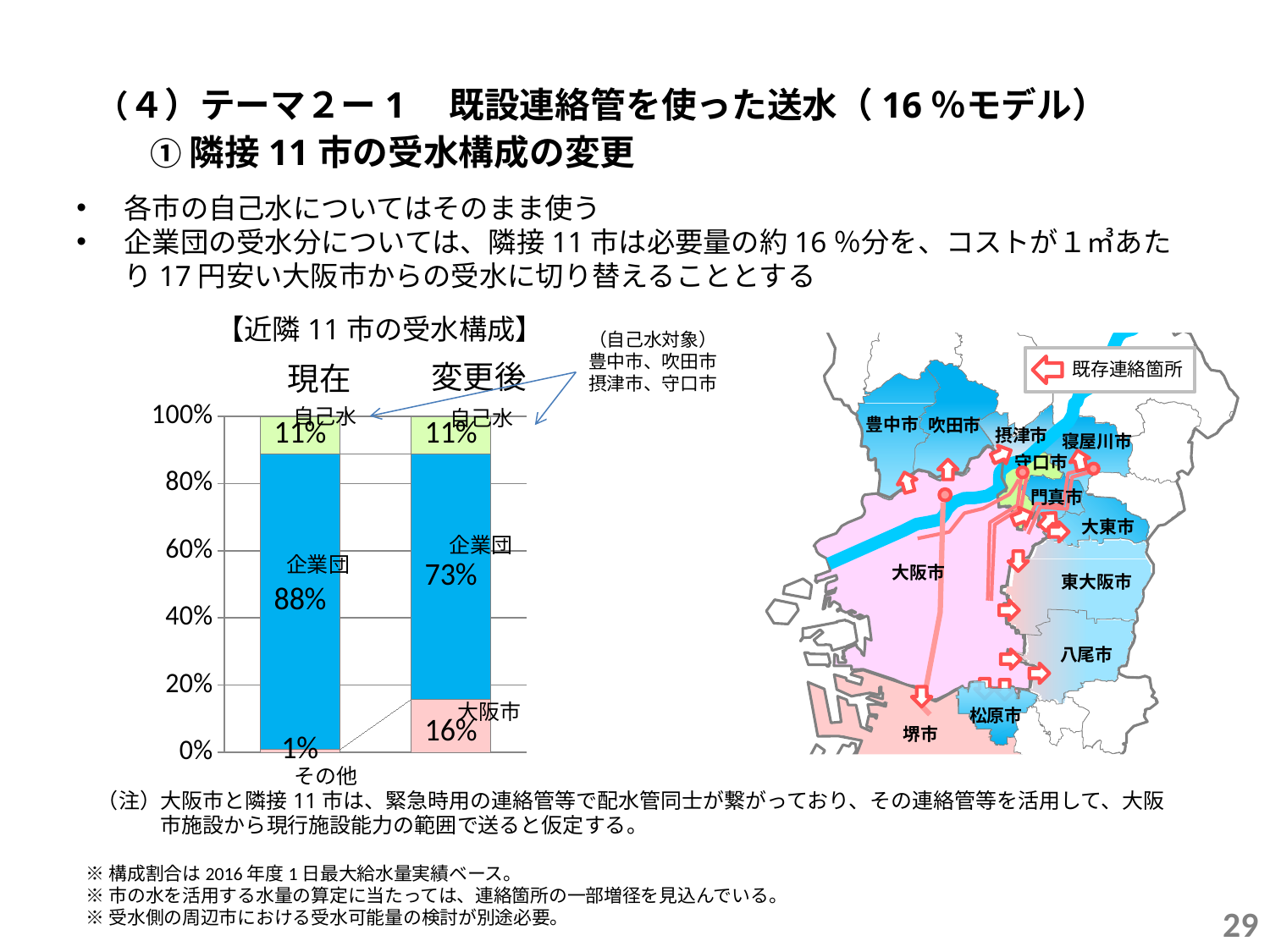
In the 【近隣11市の受水構成】 chart, which segment is the smallest in the 現在 bar? その他 In the 【近隣11市の受水構成】 chart, what is the その他 share for 現在? 1% In the 【近隣11市の受水構成】 chart, which segment is the largest in the 変更後 bar? 企業団 In the 【近隣11市の受水構成】 chart, what is the 自己水 share for 現在? 11% In the 【近隣11市の受水構成】 chart, what is the total of the 変更後 bar (自己水 + 企業団 + 大阪市)? 100% In the 【近隣11市の受水構成】 chart, is the 企業団 share for 現在 or for 変更後 larger? 現在 In the 【近隣11市の受水構成】 chart, what is the 大阪市 share for 変更後? 16% In the 【近隣11市の受水構成】 chart, what is the 企業団 share for 変更後? 73% In the 【近隣11市の受水構成】 chart, what is the 企業団 share for 現在? 88% How many bars are shown in the 【近隣11市の受水構成】 chart? 2 What kind of chart is shown under the heading 【近隣11市の受水構成】? stacked bar chart In the 【近隣11市の受水構成】 chart, by how many percentage points does the 企業団 share fall from 現在 to 変更後? 15 percentage points